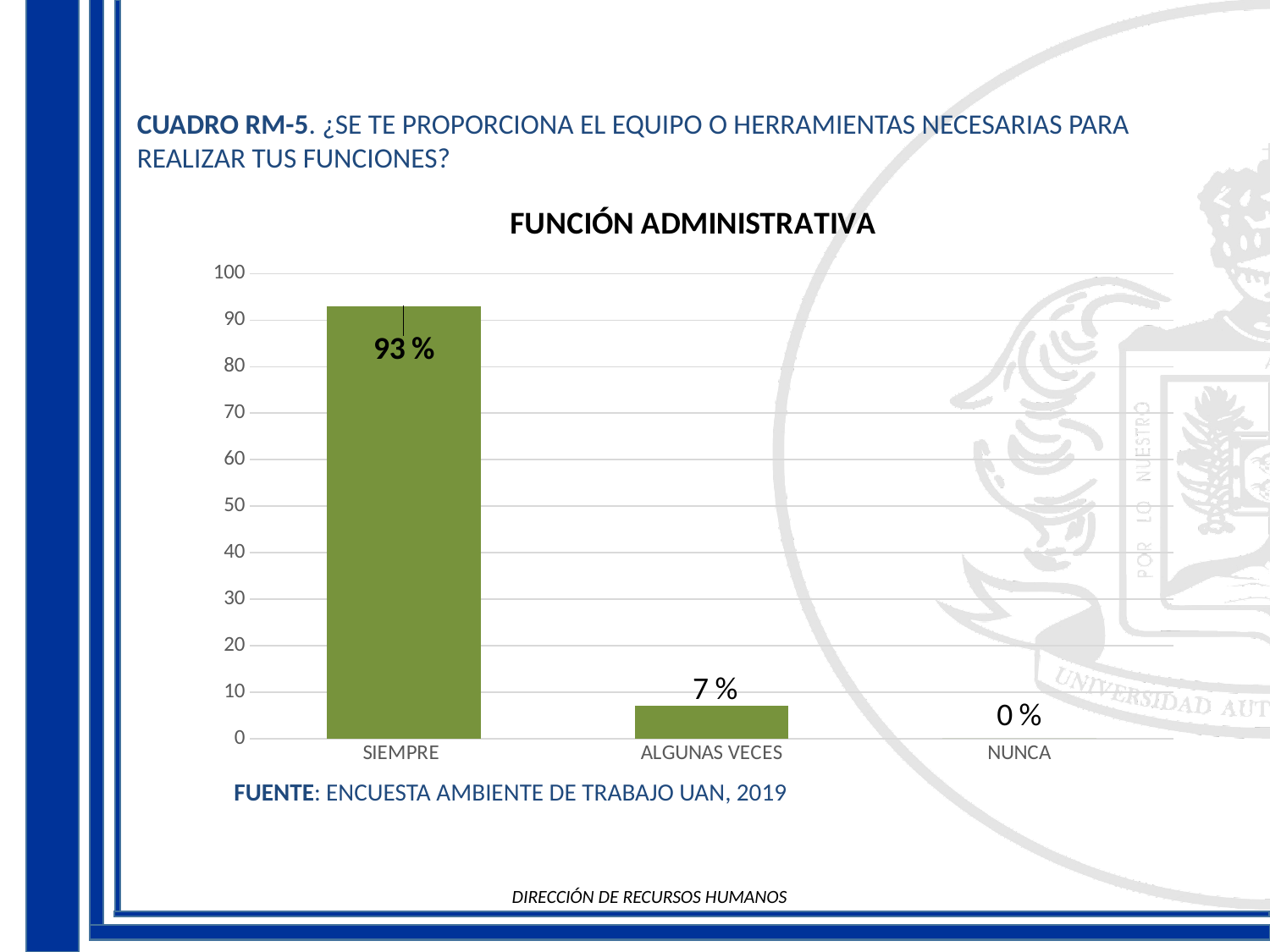
What is the difference between the values for SIEMPRE and ALGUNAS VECES? 86 % Which category has the lowest value? NUNCA What is the title of the chart? FUNCIÓN ADMINISTRATIVA What kind of chart is shown? bar chart Which category has the highest value? SIEMPRE What is the value for NUNCA? 0 % How many categories are shown on the x axis? 3 Which is larger, the value for ALGUNAS VECES or the value for NUNCA? ALGUNAS VECES What is the value for ALGUNAS VECES? 7 % Is the value for SIEMPRE greater or less than 90? greater What is the value for SIEMPRE? 93 % Do the values rise or fall from left to right along the x axis? fall